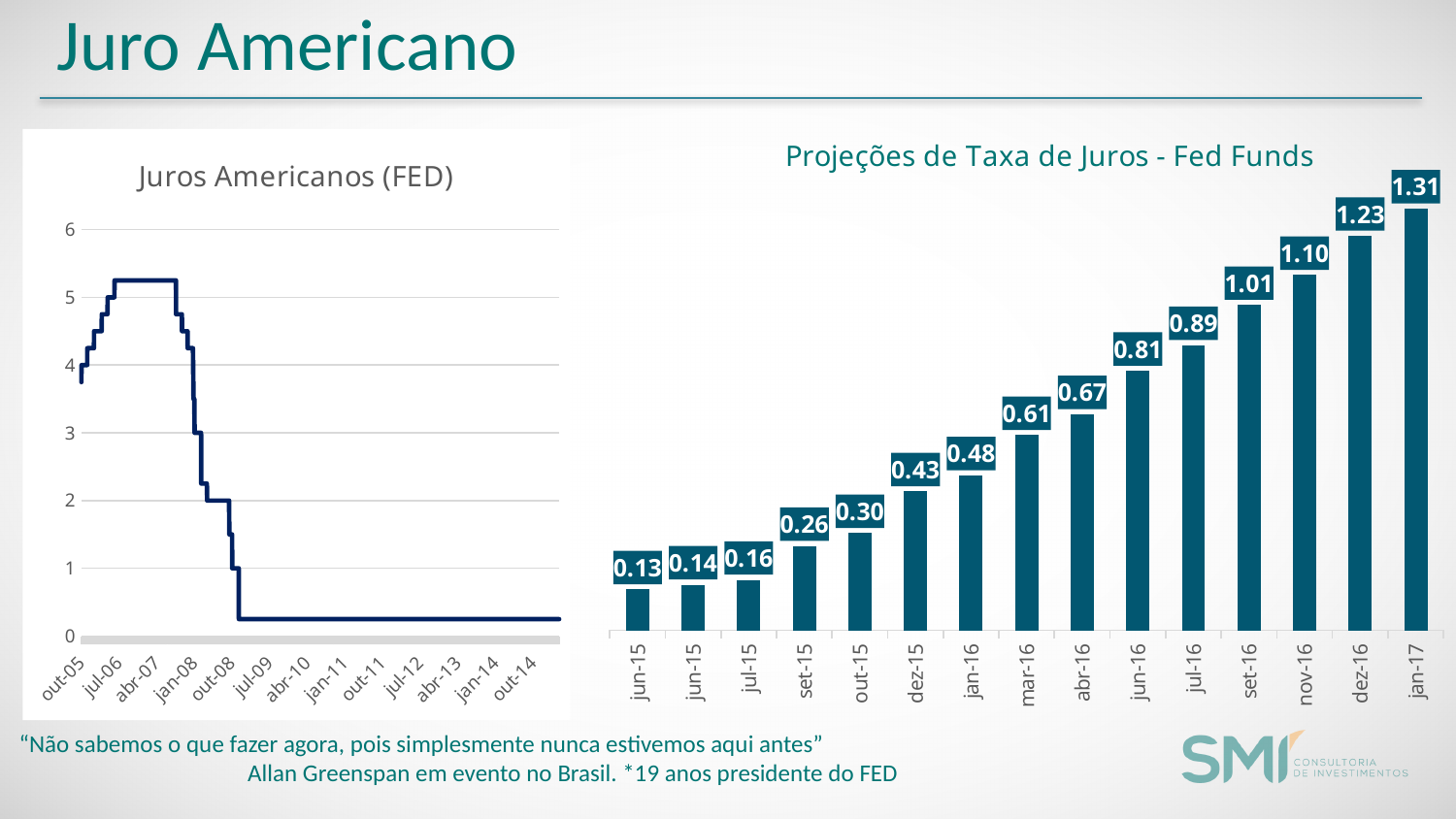
In the 'Juros Americanos (FED)' chart, is the value at out-14 greater or less than 1? less In the 'Projeções de Taxa de Juros - Fed Funds' chart, what is the value for set-16? 1.01 What kind of chart is 'Juros Americanos (FED)'? line chart In the 'Projeções de Taxa de Juros - Fed Funds' chart, which category has the highest value? jan-17 In the 'Projeções de Taxa de Juros - Fed Funds' chart, what is the value for jan-17? 1.31 In the 'Projeções de Taxa de Juros - Fed Funds' chart, what is the difference between the values for dez-16 and nov-16? 0.13 What kind of chart is 'Projeções de Taxa de Juros - Fed Funds'? bar chart In the 'Juros Americanos (FED)' chart, is the value at abr-07 greater or less than 5? greater In the 'Projeções de Taxa de Juros - Fed Funds' chart, which is larger, the value for mar-16 or the value for abr-16? abr-16 In the 'Projeções de Taxa de Juros - Fed Funds' chart, what is the value for dez-15? 0.43 In the 'Projeções de Taxa de Juros - Fed Funds' chart, do the values rise or fall from left to right? rise In the 'Projeções de Taxa de Juros - Fed Funds' chart, how many bars are plotted? 15